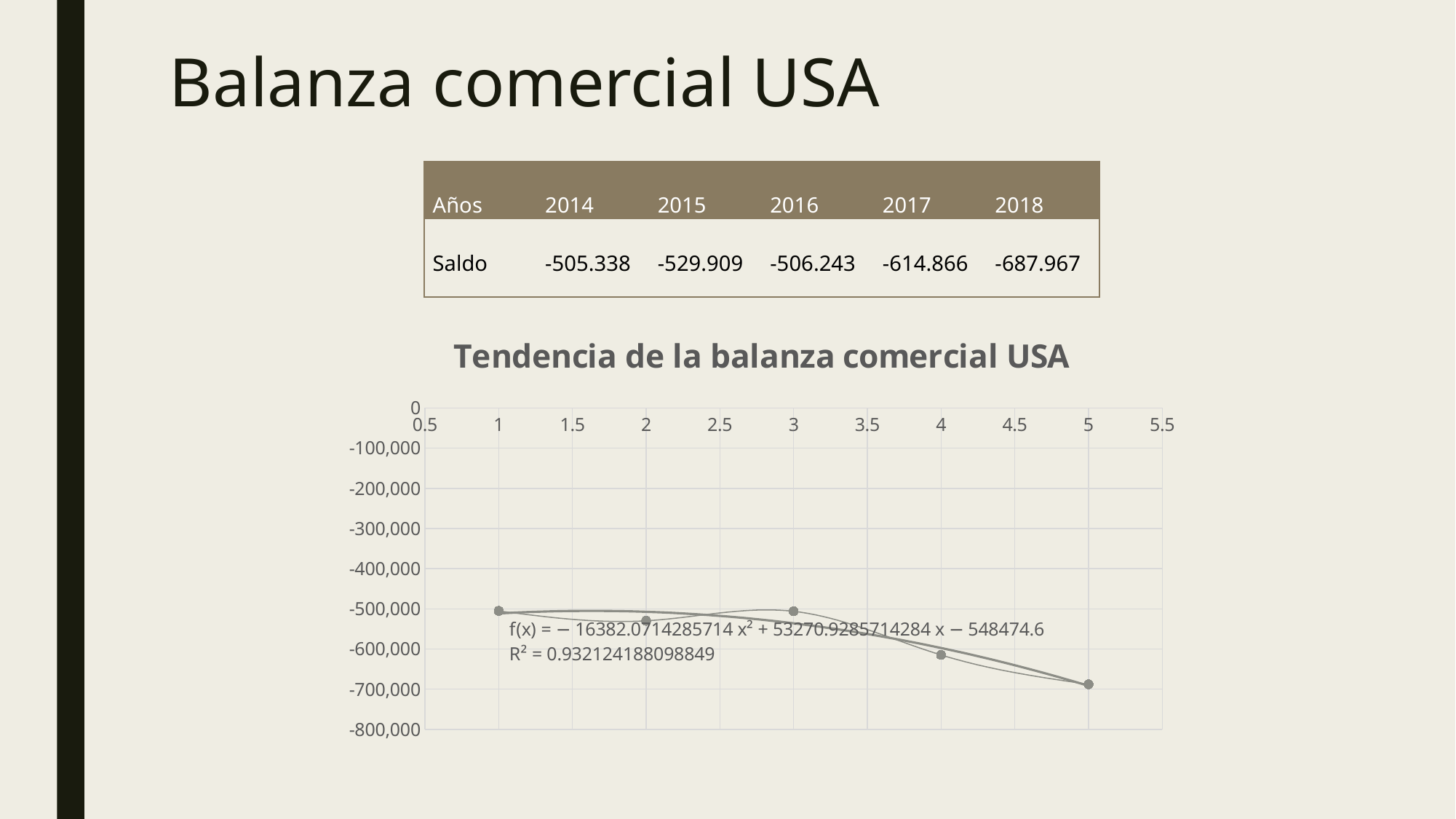
How many data points are plotted in the chart? 5 What is the title of the chart? Tendencia de la balanza comercial USA What R² value is shown for the trendline in the chart? 0.932124188098849 Is the plotted value at x = 1 greater or less than -600,000? greater Which plotted point is higher, the one at x = 1 or the one at x = 5? x = 1 Is the plotted value at x = 5 greater or less than -600,000? less Do the plotted values generally rise or fall from x = 1 to x = 5? fall Which x value has the lowest plotted point in the chart? 5 Is the plotted value at x = 2 greater or less than -400,000? less Which plotted point is higher, the one at x = 2 or the one at x = 4? x = 2 What kind of chart is shown on the slide? scatter chart